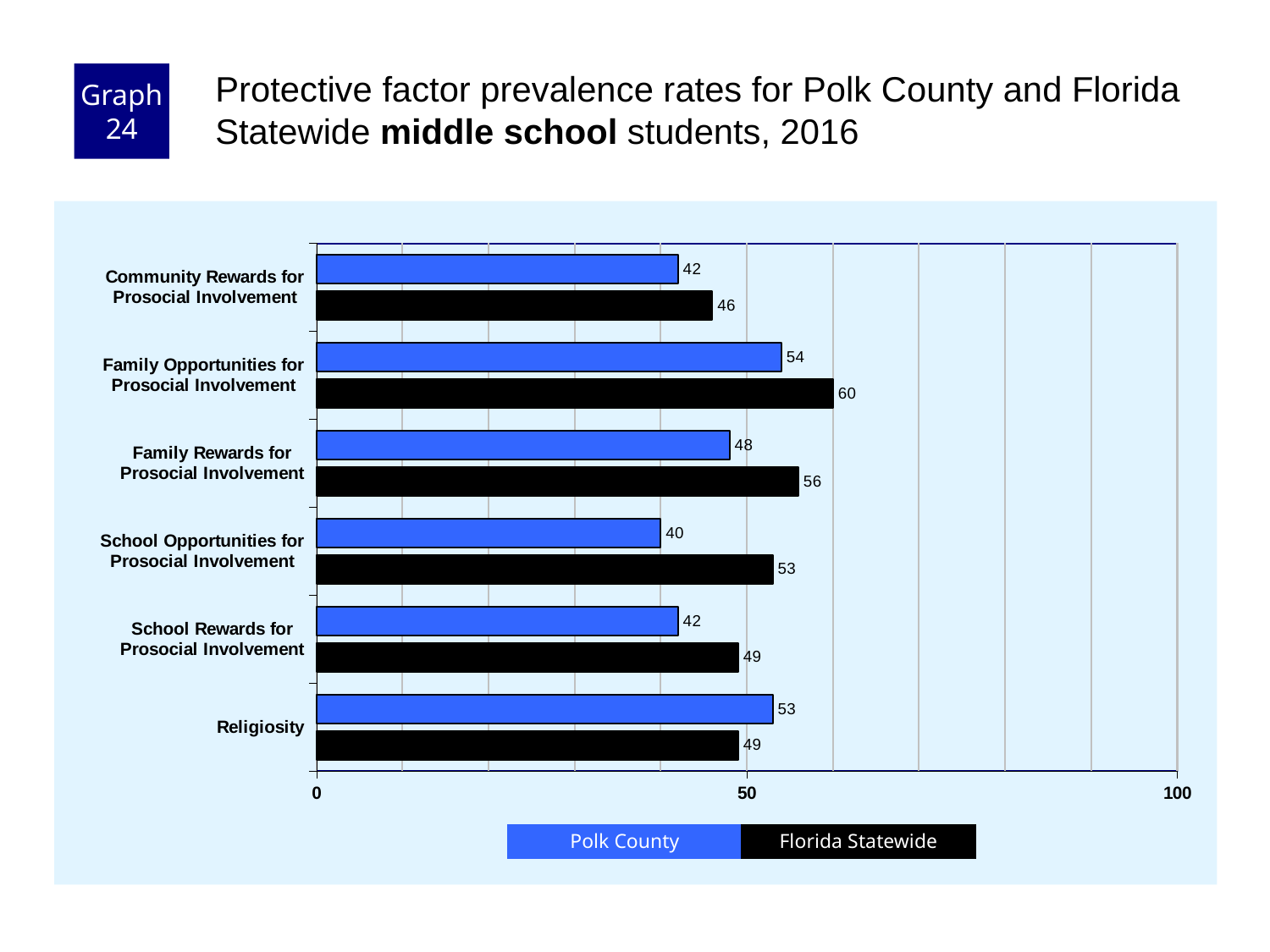
How many series does the legend list? 2 Which category has the lowest Polk County value? School Opportunities for Prosocial Involvement What colour are the Florida Statewide bars? black How many categories are shown on the chart? 6 What is the Polk County value for Family Opportunities for Prosocial Involvement? 54 What is the difference between the Florida Statewide and Polk County values for School Opportunities for Prosocial Involvement? 13 Is the Florida Statewide value for Family Rewards for Prosocial Involvement greater or less than 50? greater For Religiosity, which is larger: the Polk County value or the Florida Statewide value? Polk County What is the Florida Statewide value for School Opportunities for Prosocial Involvement? 53 What kind of chart is shown on the slide? bar chart What is the Polk County value for Religiosity? 53 Which category has the highest Florida Statewide value? Family Opportunities for Prosocial Involvement